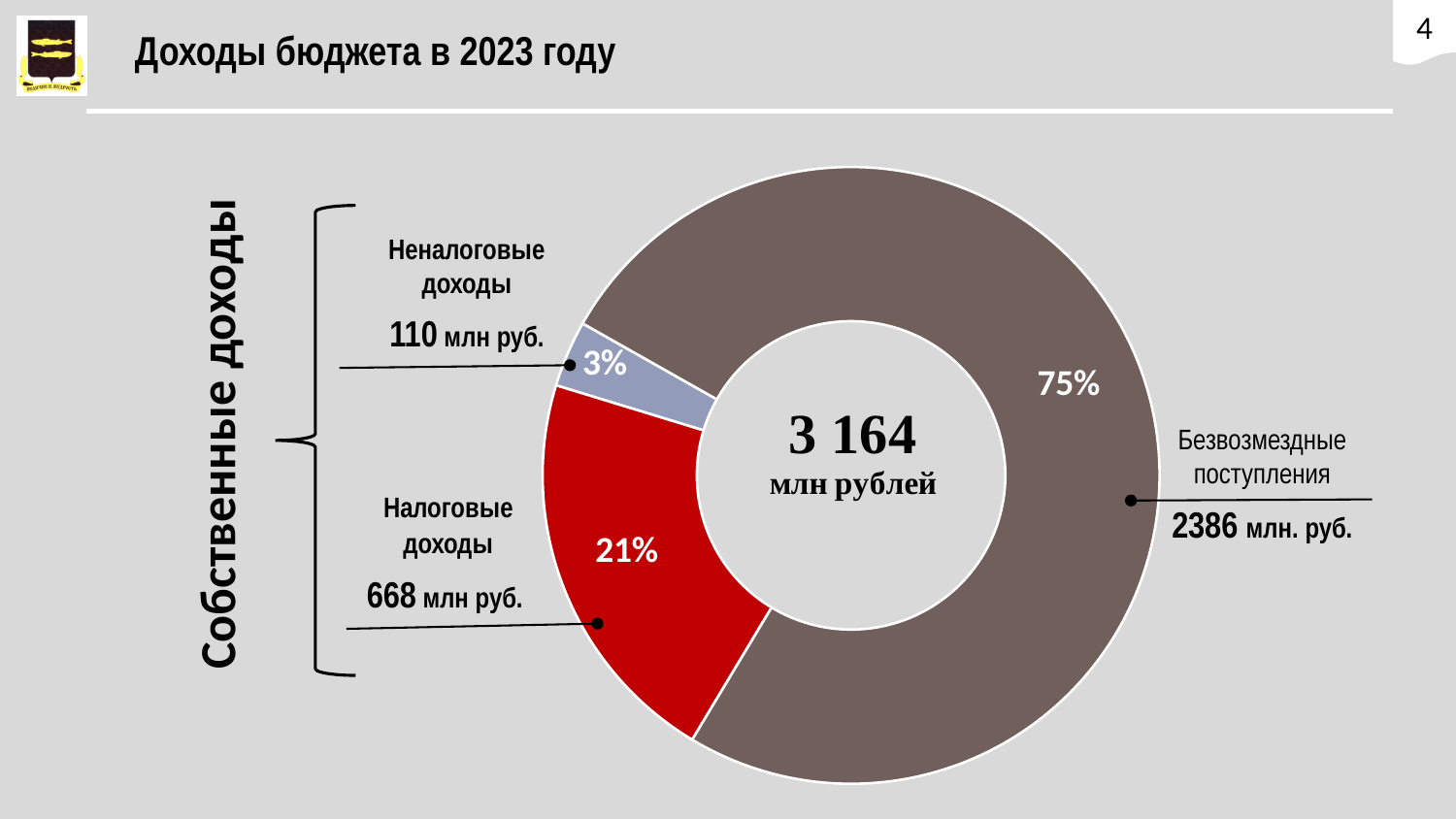
What is the value shown for Налоговые доходы? 668 млн руб. What total value is shown in the centre of the donut chart? 3 164 млн рублей Which is larger, Налоговые доходы or Неналоговые доходы? Налоговые доходы What is the value shown for Неналоговые доходы? 110 млн руб. Which category has the largest share of the donut chart? Безвозмездные поступления What share of the donut chart does Неналоговые доходы represent? 3% What share of the donut chart does Налоговые доходы represent? 21% Which category has the smallest share of the donut chart? Неналоговые доходы How many segments does the donut chart have? 3 What is the difference in млн руб. between Налоговые доходы and Неналоговые доходы? 558 млн руб. What is the value shown for Безвозмездные поступления? 2386 млн. руб. What share of the donut chart does Безвозмездные поступления represent? 75%